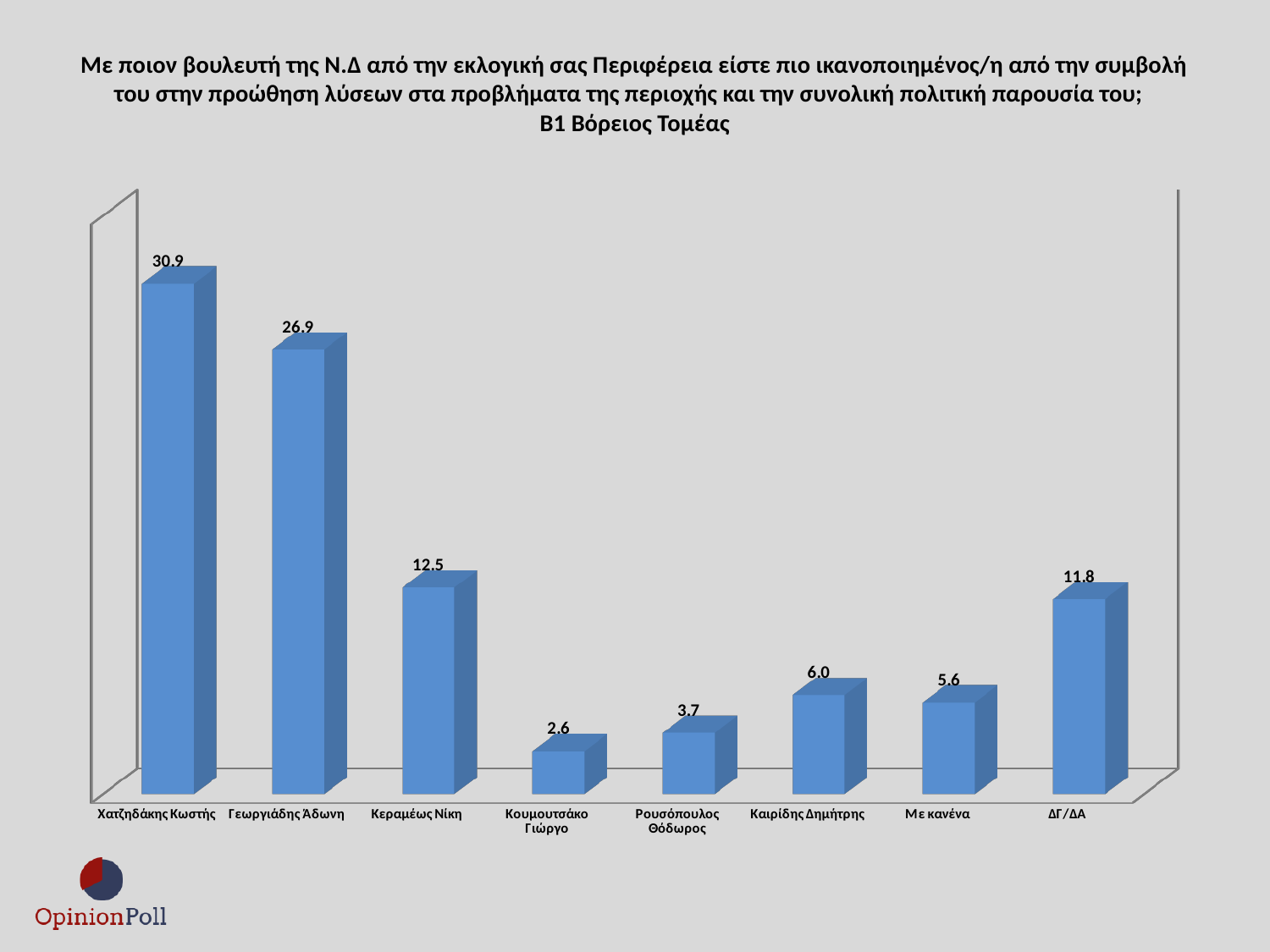
Which category has the highest value? Χατζηδάκης Κωστής What is the difference between the values for Χατζηδάκης Κωστής and Γεωργιάδης Άδωνη? 4.0 What is the value for Κεραμέως Νίκη? 12.5 What is the value for ΔΓ/ΔΑ? 11.8 How many categories are shown on the x axis? 8 Which is larger, the value for Κεραμέως Νίκη or the value for ΔΓ/ΔΑ? Κεραμέως Νίκη What is the difference between the values for Καιρίδης Δημήτρης and Ρουσόπουλος Θόδωρος? 2.3 Which category has the lowest value? Κουμουτσάκο Γιώργο What is the value for Με κανένα? 5.6 Which sector (τομέας) does the chart title refer to? Β1 Βόρειος Τομέας What is the value for Χατζηδάκης Κωστής? 30.9 What kind of chart is shown on the slide? bar chart